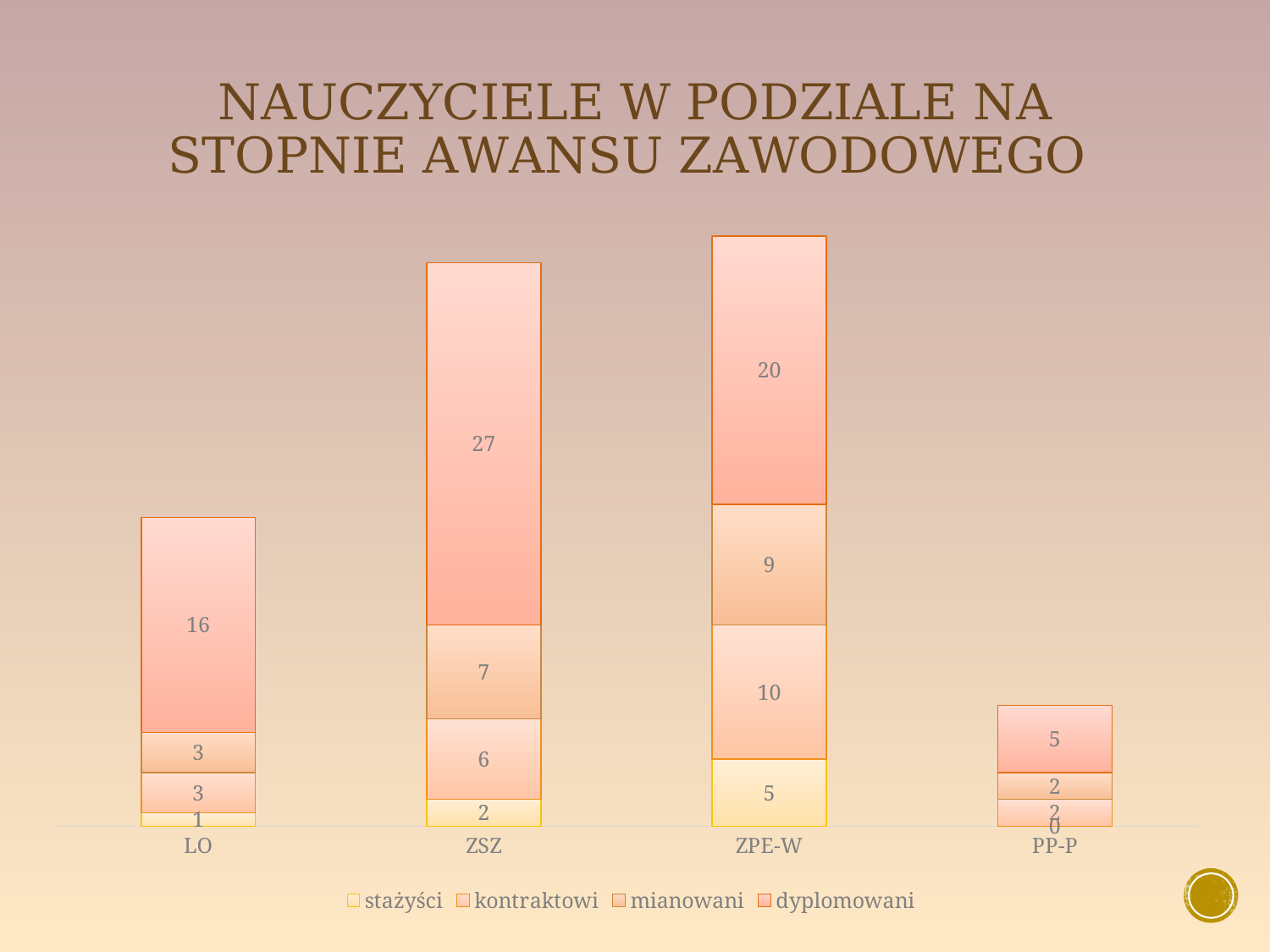
What kind of chart is shown on the slide? stacked bar chart What is the difference between the dyplomowani values for ZSZ and LO? 11 How many categories are shown on the x axis? 4 Which is larger: the mianowani value for ZPE-W or the mianowani value for ZSZ? ZPE-W What is the total of the stacked bar for ZPE-W? 44 How many series does the legend list? 4 What is the value for stażyści in the PP-P category? 0 What is the value for kontraktowi in the LO category? 3 Which category has the lowest total stacked bar? PP-P What is the value for dyplomowani in the ZSZ category? 27 What is the value for stażyści in the ZPE-W category? 5 Which category has the highest value for dyplomowani? ZSZ